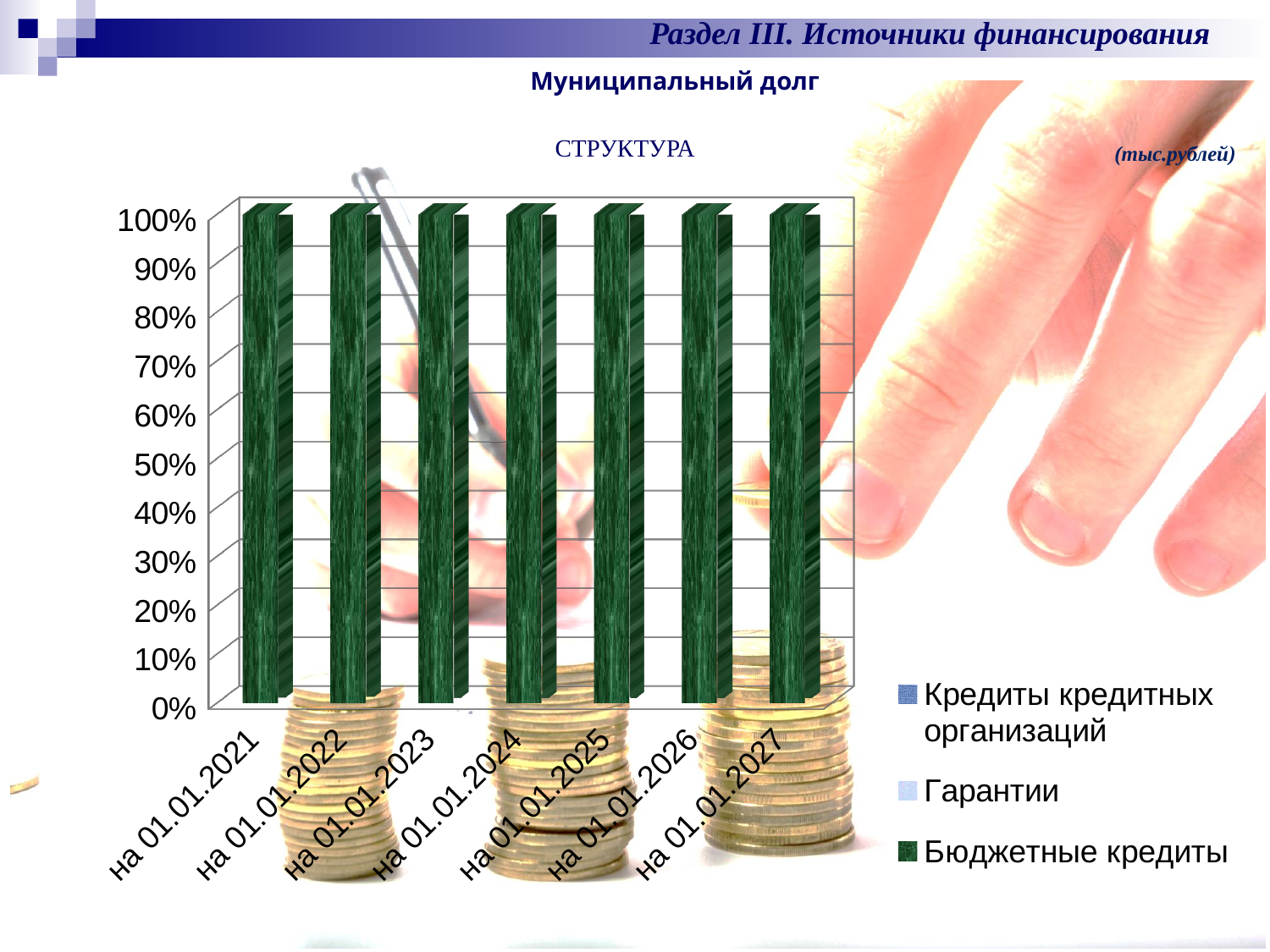
How many categories (dates) are shown on the x axis of the chart? 7 What is the highest tick value shown on the vertical axis of the chart? 100% What kind of chart is shown on the slide? bar chart What is the first category on the x axis of the chart? на 01.01.2021 How many series does the chart legend list? 3 Does the share of Бюджетные кредиты rise, fall or stay the same across the dates on the x axis? stays the same Is the value for Бюджетные кредиты at на 01.01.2024 greater or less than 50%? greater What share does Бюджетные кредиты have in the bar for на 01.01.2027? 100% What is the title of the chart? СТРУКТУРА What share does Бюджетные кредиты have in the bar for на 01.01.2021? 100% Which series is shown in green in the chart legend? Бюджетные кредиты